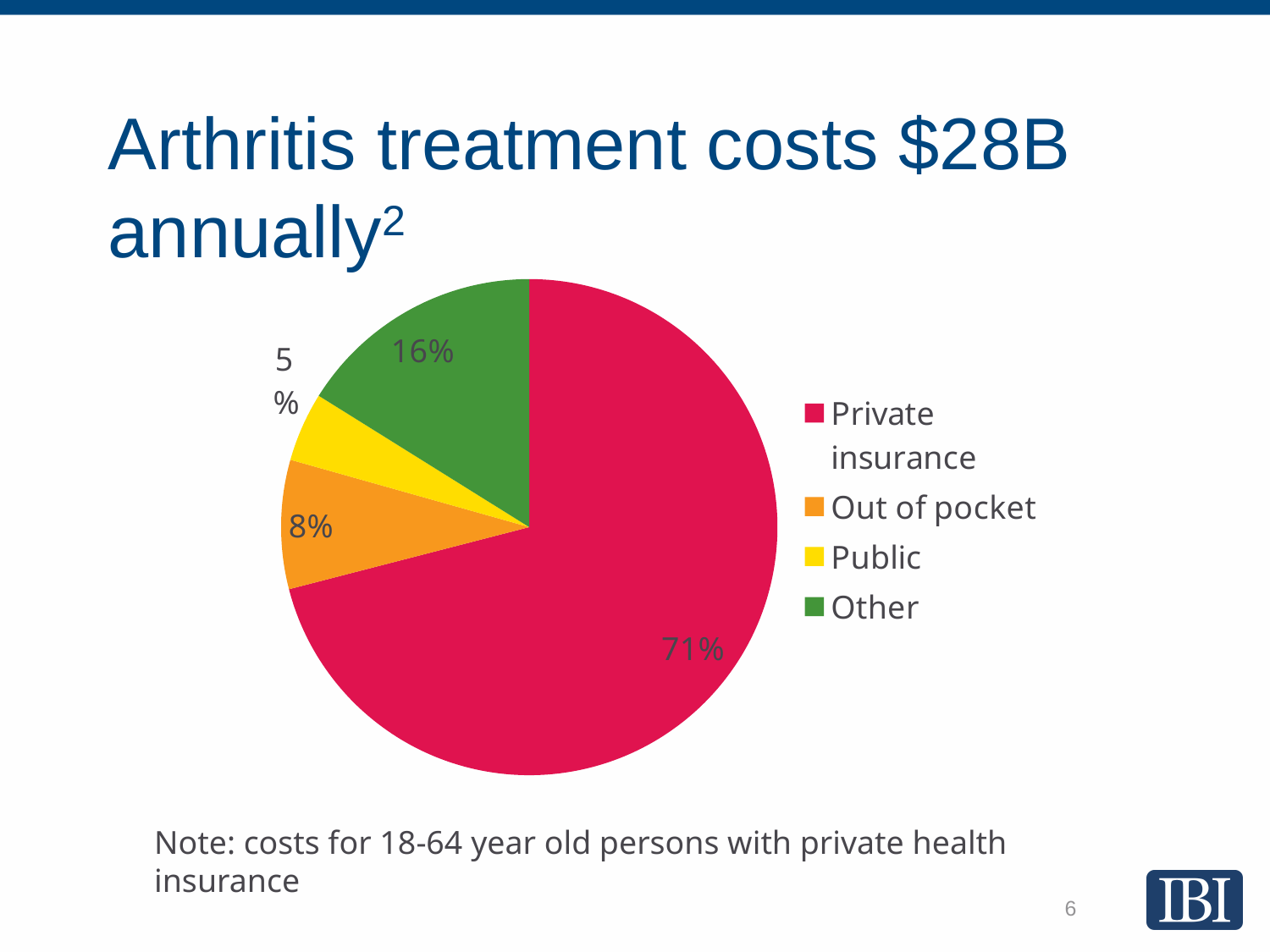
What share of arthritis treatment costs is covered by public sources? 5% What colour represents Out of pocket in the pie chart? Orange What kind of chart is shown on the slide? Pie chart What share of arthritis treatment costs is covered by private insurance? 71% What is the combined share of Out of pocket and Public costs? 13% What share of arthritis treatment costs is paid out of pocket? 8% Which category accounts for the largest share of the pie? Private insurance What is the difference in percentage points between the Private insurance share and the Other share? 55 Which is larger, the Out of pocket share or the Public share? Out of pocket What share of arthritis treatment costs falls under Other? 16% How many categories does the pie chart show? 4 Which category accounts for the smallest share of the pie? Public